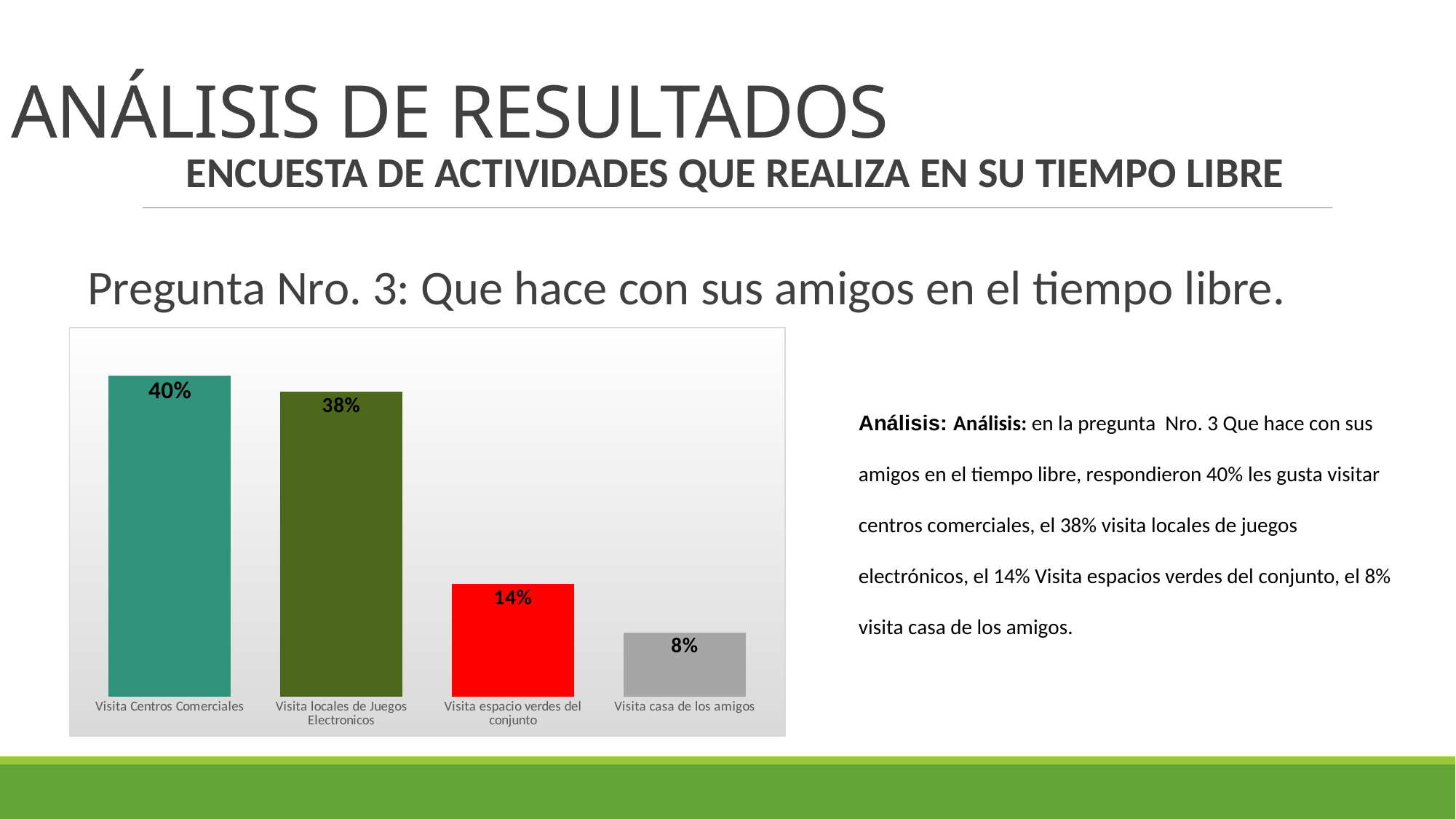
Which category has the highest value? Visita Centros Comerciales What is the difference between Visita Centros Comerciales and Visita casa de los amigos? 32% What is the value for Visita locales de Juegos Electronicos? 38% Do the values rise or fall from left to right across the categories? Fall What is the value for Visita casa de los amigos? 8% Which is larger, Visita espacio verdes del conjunto or Visita casa de los amigos? Visita espacio verdes del conjunto What kind of chart is shown on the slide? Bar chart Which category has the lowest value? Visita casa de los amigos What is the difference between Visita locales de Juegos Electronicos and Visita espacio verdes del conjunto? 24% How many categories are shown in the chart? 4 What is the value for Visita Centros Comerciales? 40% What is the value for Visita espacio verdes del conjunto? 14%